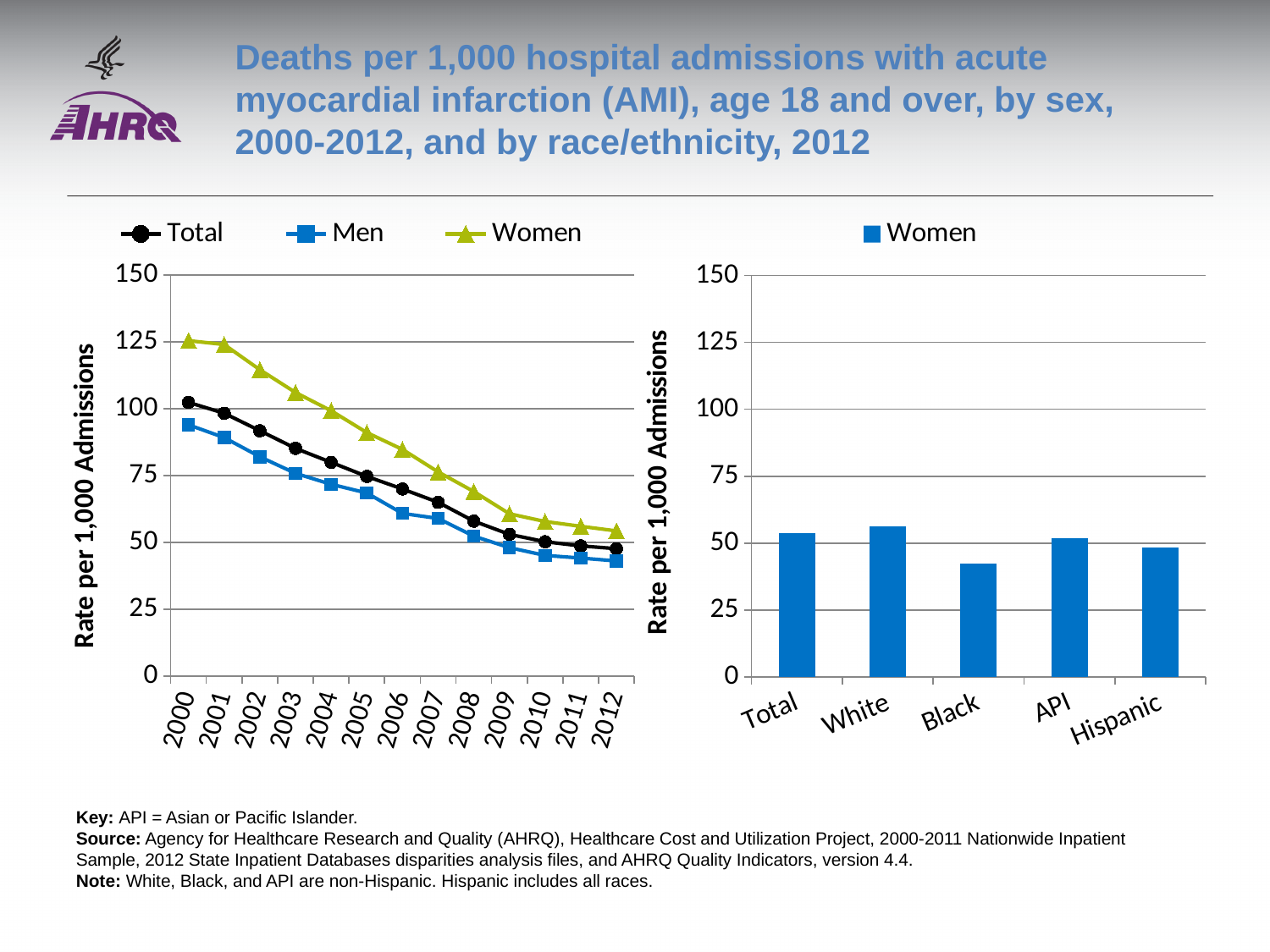
How many series does the legend of the left chart list? 3 How many years are plotted along the x axis of the left chart? 13 What kind of chart is the chart on the left side of the slide? line chart How many race/ethnicity categories are shown in the right chart? 5 In the left chart, is the value for Men in 2012 greater or less than 50? less In the left chart, which series has the highest rate in 2000: Men or Women? Women In the left chart, do the rates for Women rise or fall from 2000 to 2012? fall In the right chart, is the value for Black greater or less than 50? less In the right chart, which is larger, the value for White or the value for Black? White In the left chart, is the value for Women in 2000 greater or less than 100? greater In the right chart, which category has the lowest rate? Black What kind of chart is the chart on the right side of the slide? bar chart